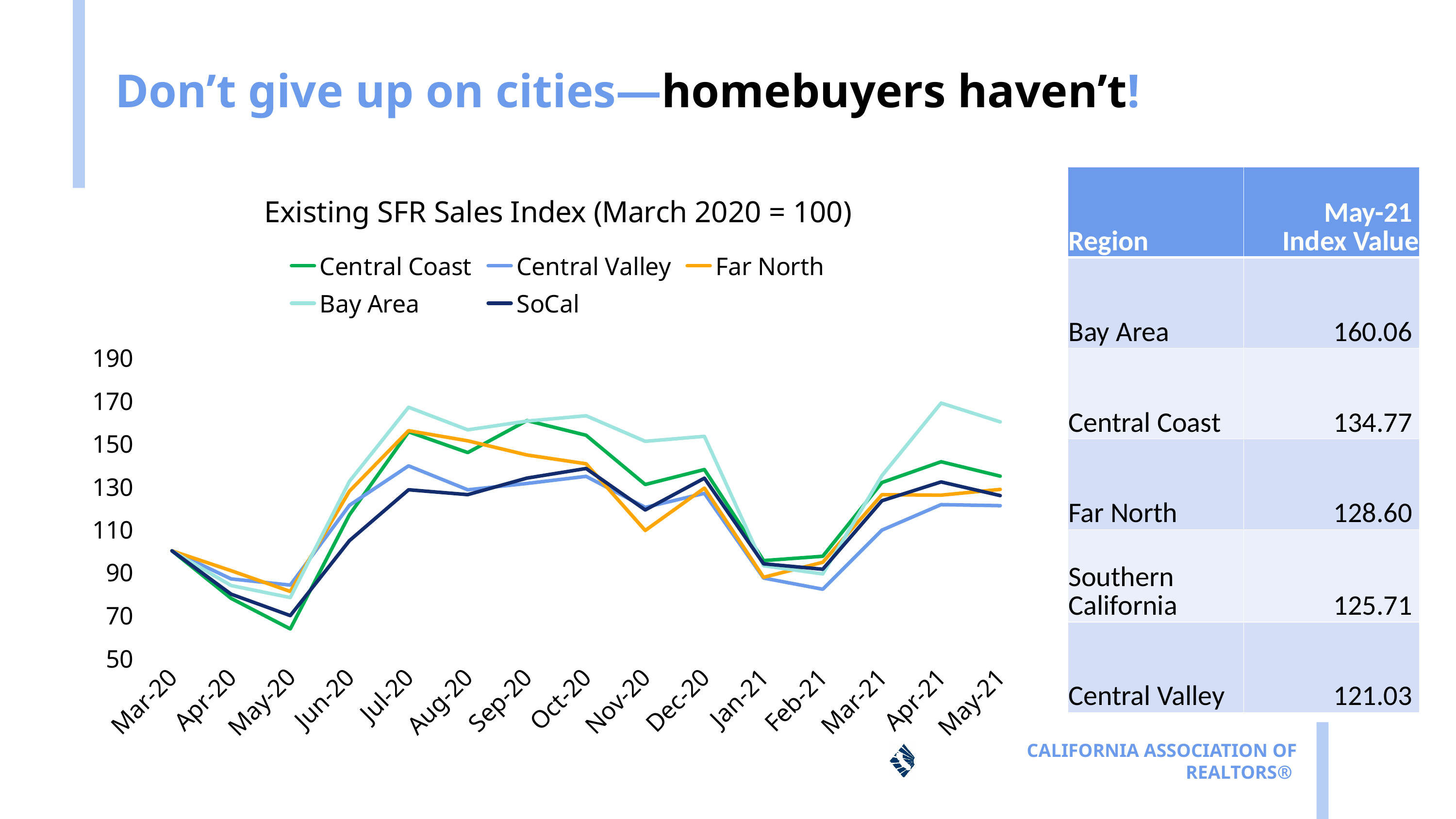
How many months are shown along the x axis of the chart? 15 Is the Bay Area value for Jul-20 greater or less than 150? greater What kind of chart is shown on the slide? line chart What is the difference between the May-21 index values of the Bay Area and Central Valley? 39.03 How many series does the chart legend list? 5 Do the index values rise or fall from Mar-20 to May-20? fall According to the table, what is the May-21 index value for the Bay Area? 160.06 Which region has the highest May-21 index value? Bay Area In May-21, which has the larger index value, Central Coast or Far North? Central Coast According to the table, what is the May-21 index value for Far North? 128.60 Which region has the lowest May-21 index value? Central Valley What is the title of the chart? Existing SFR Sales Index (March 2020 = 100)